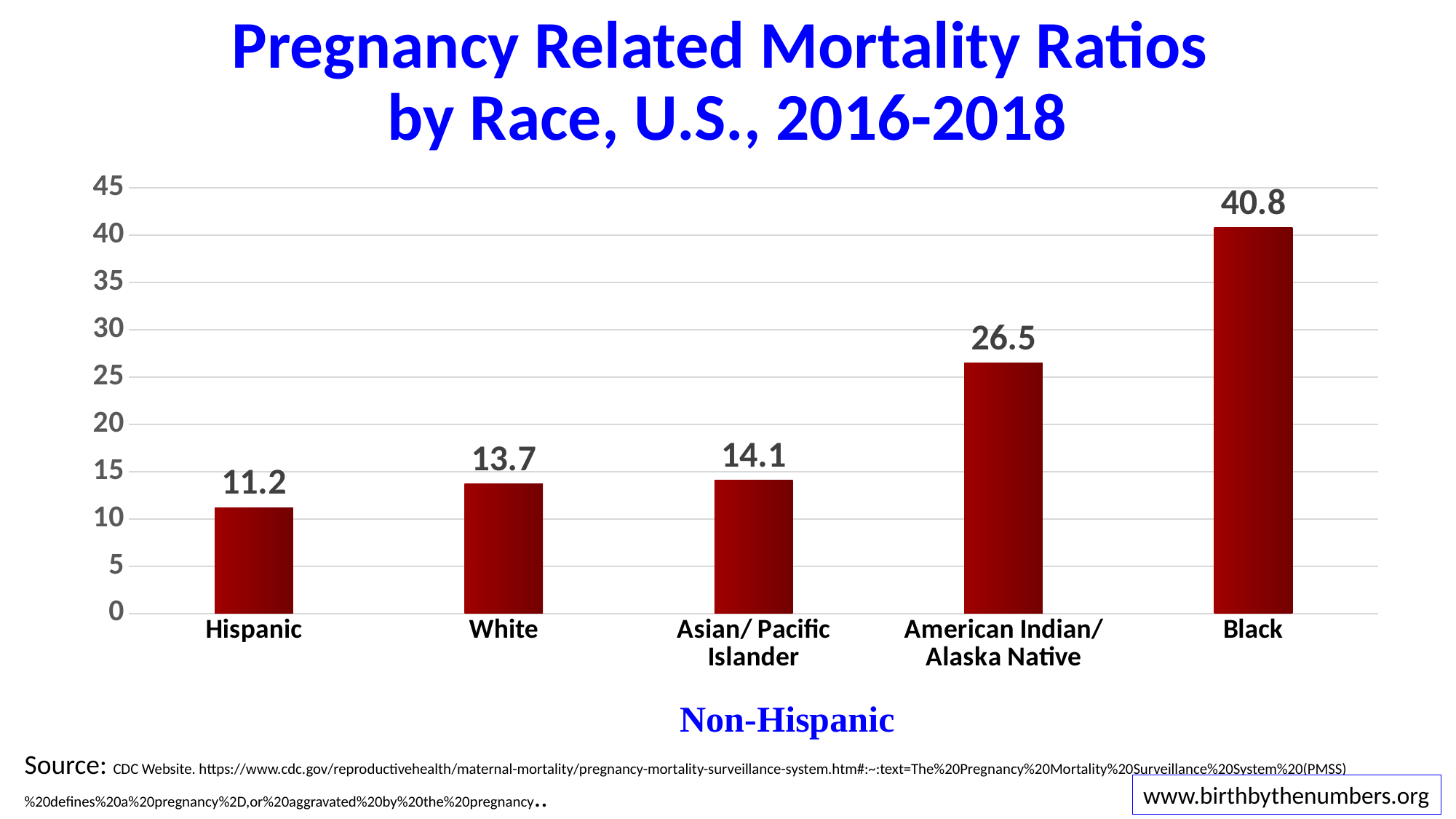
How many categories are shown in the chart? 5 What is the pregnancy related mortality ratio for Black women? 40.8 What kind of chart is shown on the slide? Bar chart What is the pregnancy related mortality ratio for Hispanic women? 11.2 What is the difference between the values for American Indian/ Alaska Native and Hispanic? 15.3 What is the difference between the values for Black and White? 27.1 What is the value shown for Asian/ Pacific Islander? 14.1 Which category has the highest pregnancy related mortality ratio? Black Which category has the lowest pregnancy related mortality ratio? Hispanic What is the value shown for American Indian/ Alaska Native? 26.5 Is the value for American Indian/ Alaska Native greater or less than 25? greater Which is larger, the value for White or the value for Asian/ Pacific Islander? Asian/ Pacific Islander